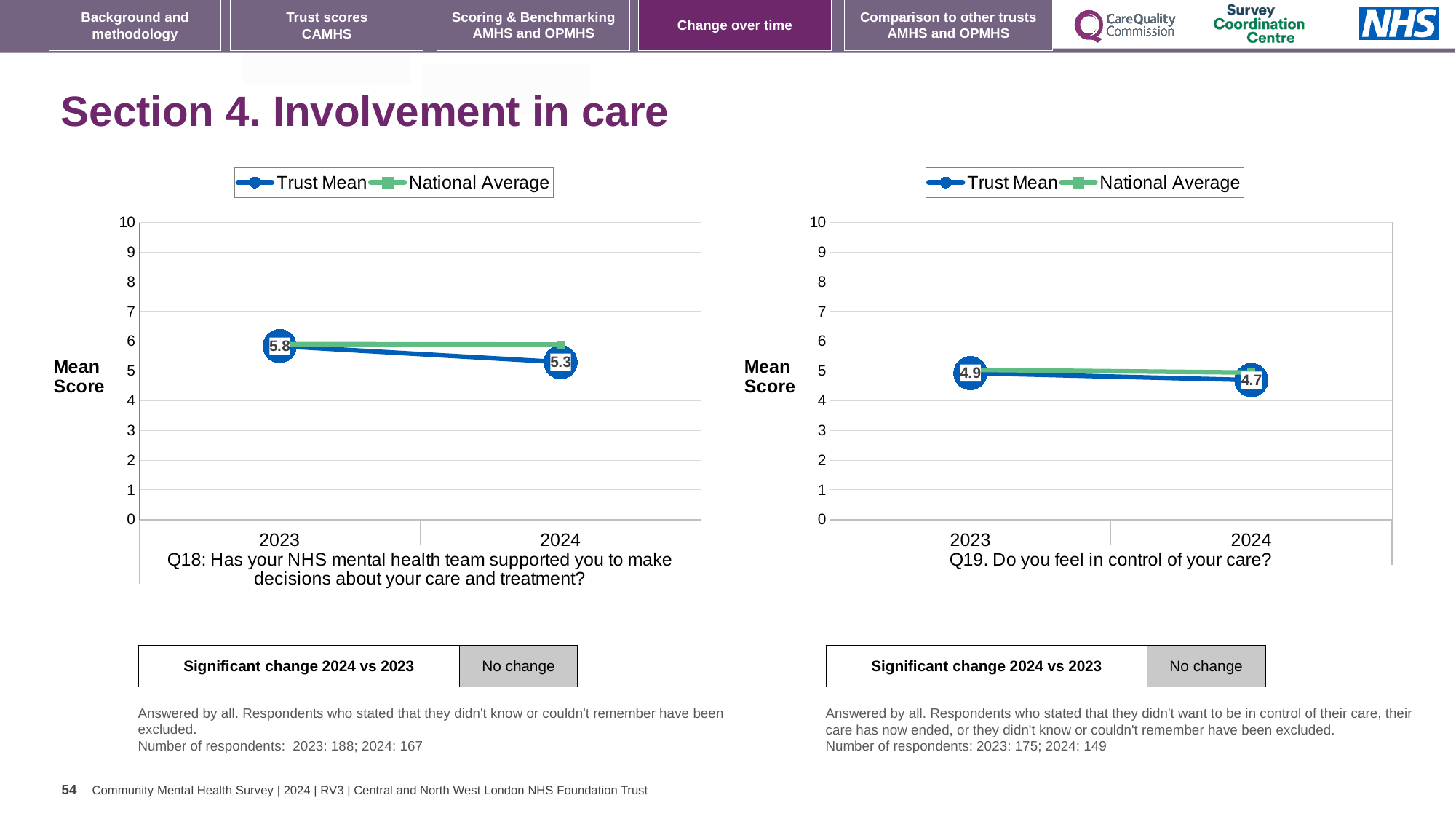
In the Q18 chart on the left, what is the Trust Mean for 2024? 5.3 What type of chart is the Q18 chart on the left? line chart In the Q19 chart on the right, what is the Trust Mean for 2024? 4.7 In the Q18 chart on the left, by how much did the Trust Mean change from 2023 to 2024? 0.5 In the Q19 chart on the right, what is the Trust Mean for 2023? 4.9 In the Q18 chart on the left, does the Trust Mean rise or fall from 2023 to 2024? fall In the Q19 chart on the right, which year has the higher Trust Mean, 2023 or 2024? 2023 In the Q19 chart on the right, what is the difference between the Trust Mean in 2023 and 2024? 0.2 In the Q18 chart on the left, what is the Trust Mean for 2023? 5.8 In the Q18 chart on the left, in 2024 which is higher, the Trust Mean or the National Average? National Average How many series does the legend of the Q19 chart on the right list? 2 In the Q18 chart on the left, is the National Average for 2024 greater or less than 5? greater